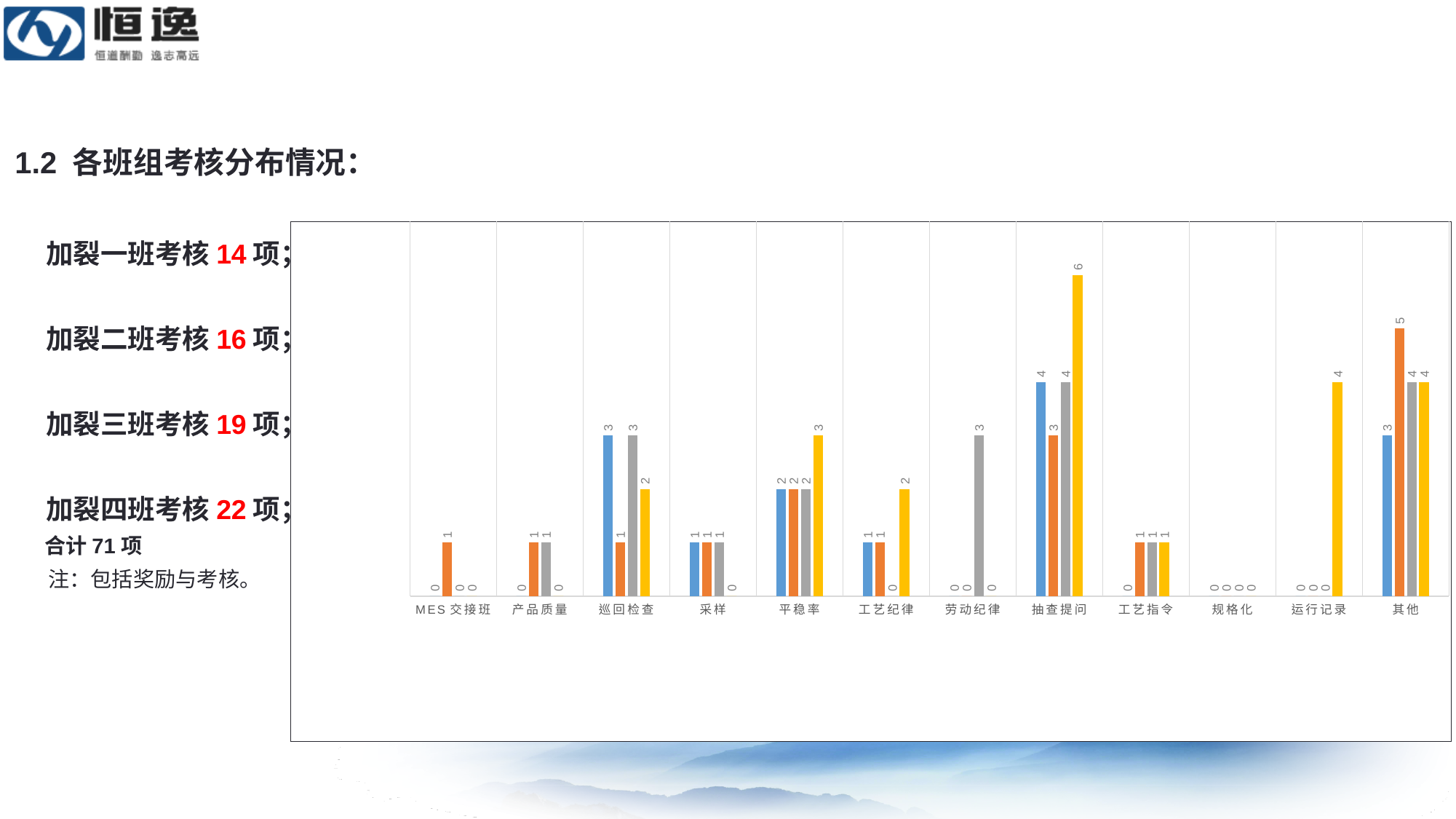
What is the total of the four bars for 抽查提问? 17 What is the value of the gray bar for 劳动纪律? 3 Which category has all four bars equal to 0? 规格化 Which category has the tallest bar in the chart? 抽查提问 Which is larger for 巡回检查: the blue bar or the orange bar? the blue bar What type of chart is shown on the slide? bar chart How many categories are shown on the x axis of the chart? 12 What is the value of the orange bar for 其他? 5 What is the value of the yellow bar for 抽查提问? 6 What is the total of the four bars for 其他? 16 What is the value of the yellow bar for 运行记录? 4 What is the difference between the yellow bar and the orange bar for 抽查提问? 3